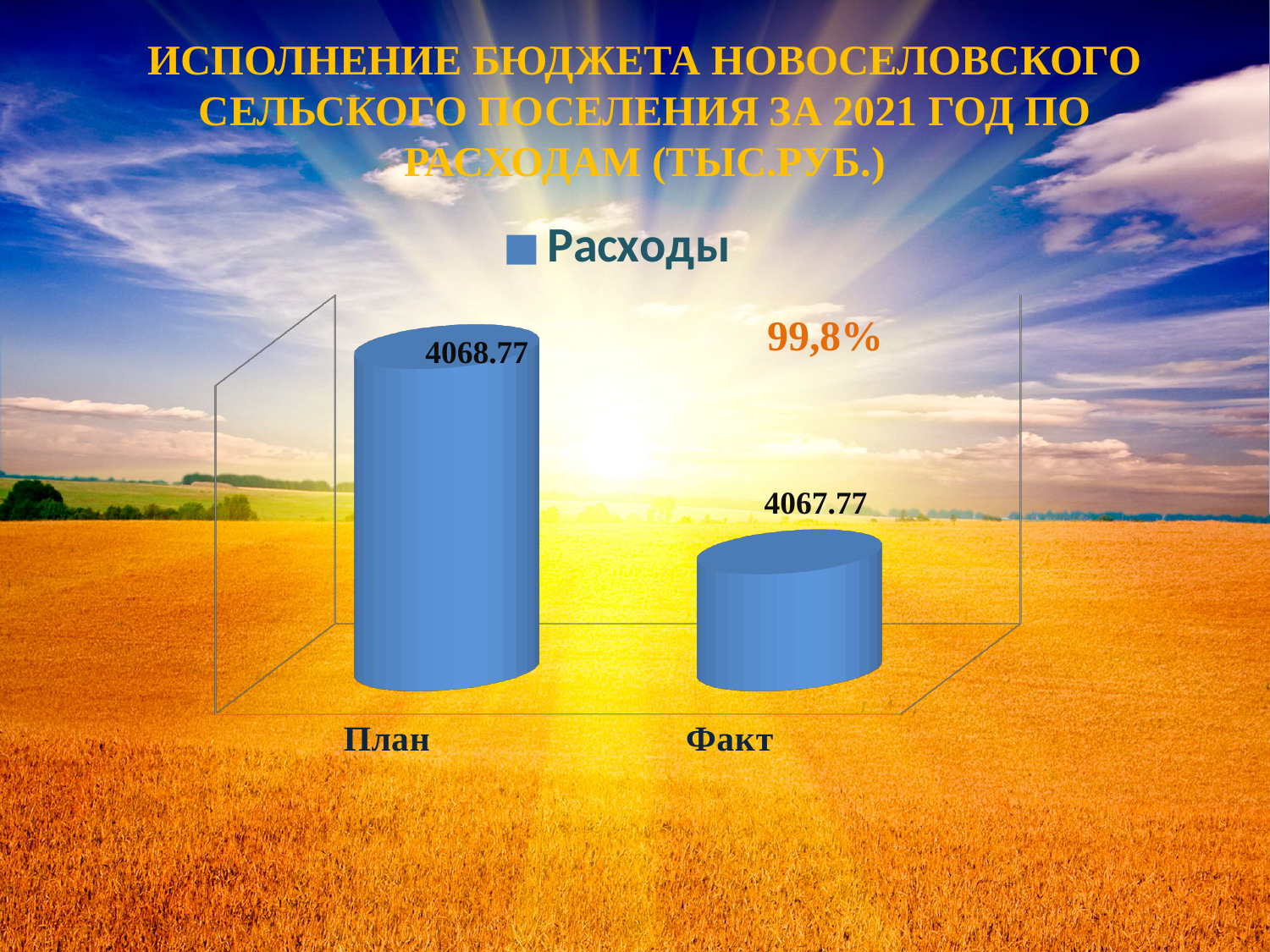
Which category has the highest value? План What kind of chart is shown on the slide? Bar chart Which is larger, the value for План or the value for Факт? План Which category has the lowest value? Факт How many categories are shown in the chart? 2 What is the difference between the values for План and Факт? 1.00 What percentage is printed above the Факт bar? 99,8% What is the value for План? 4068.77 What is the value for Факт? 4067.77 What is the name of the series shown in the legend? Расходы How many series does the legend list? 1